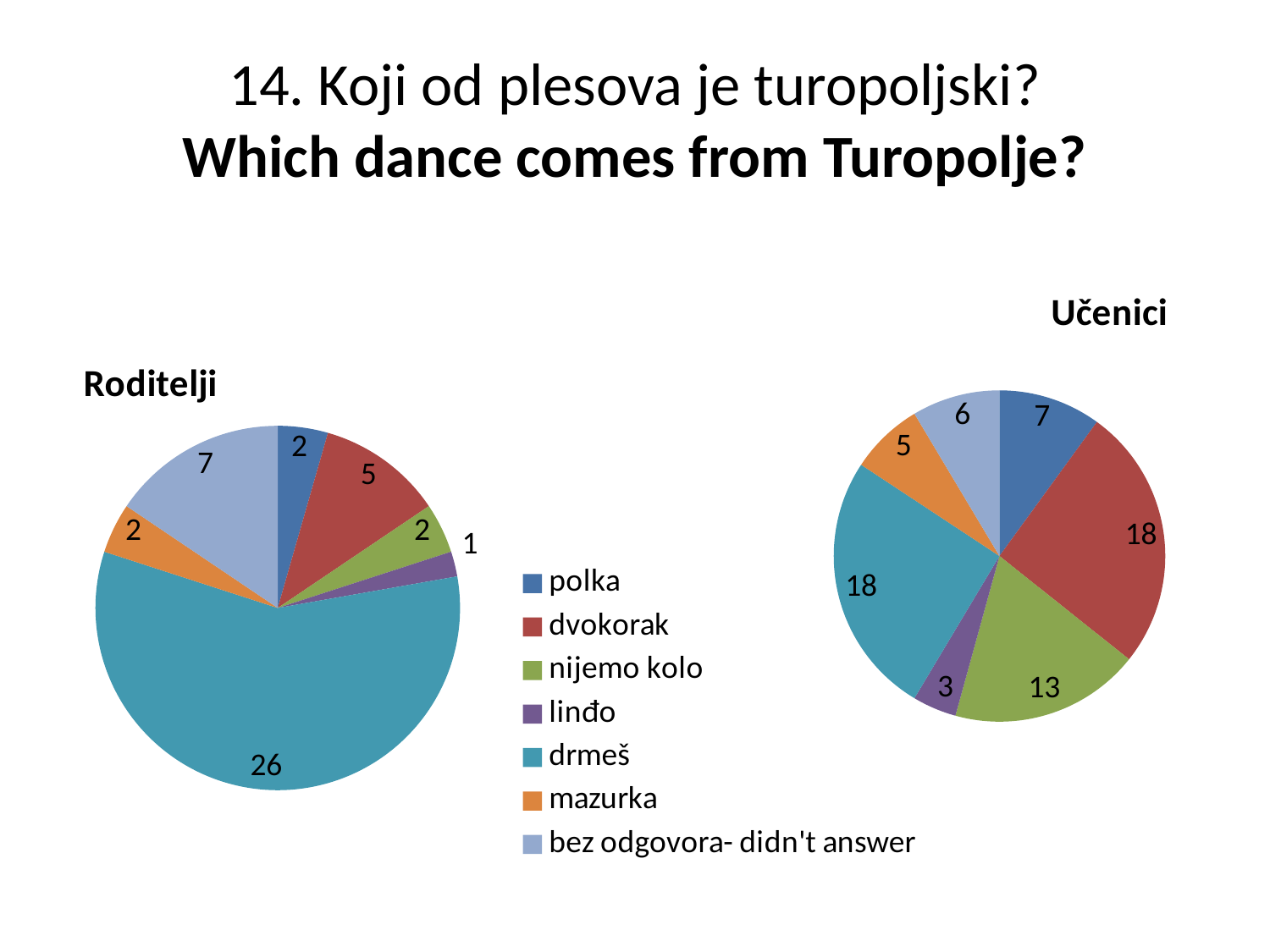
In the Roditelji chart, what is the value for bez odgovora- didn't answer? 7 In the Učenici chart, what is the difference between dvokorak and nijemo kolo? 5 In the Učenici chart, what is the value for polka? 7 In the Roditelji chart, which category has the largest slice? drmeš In the Učenici chart, which category has the smallest slice? linđo How many categories does the legend list? 7 What kind of chart is the Roditelji chart? pie chart In the Roditelji chart, what is the value for drmeš? 26 In the Učenici chart, what is the value for nijemo kolo? 13 In the Roditelji chart, which category has the smallest slice? linđo What is the total of all slices in the Roditelji chart? 45 In the Učenici chart, which is larger, mazurka or bez odgovora- didn't answer? bez odgovora- didn't answer